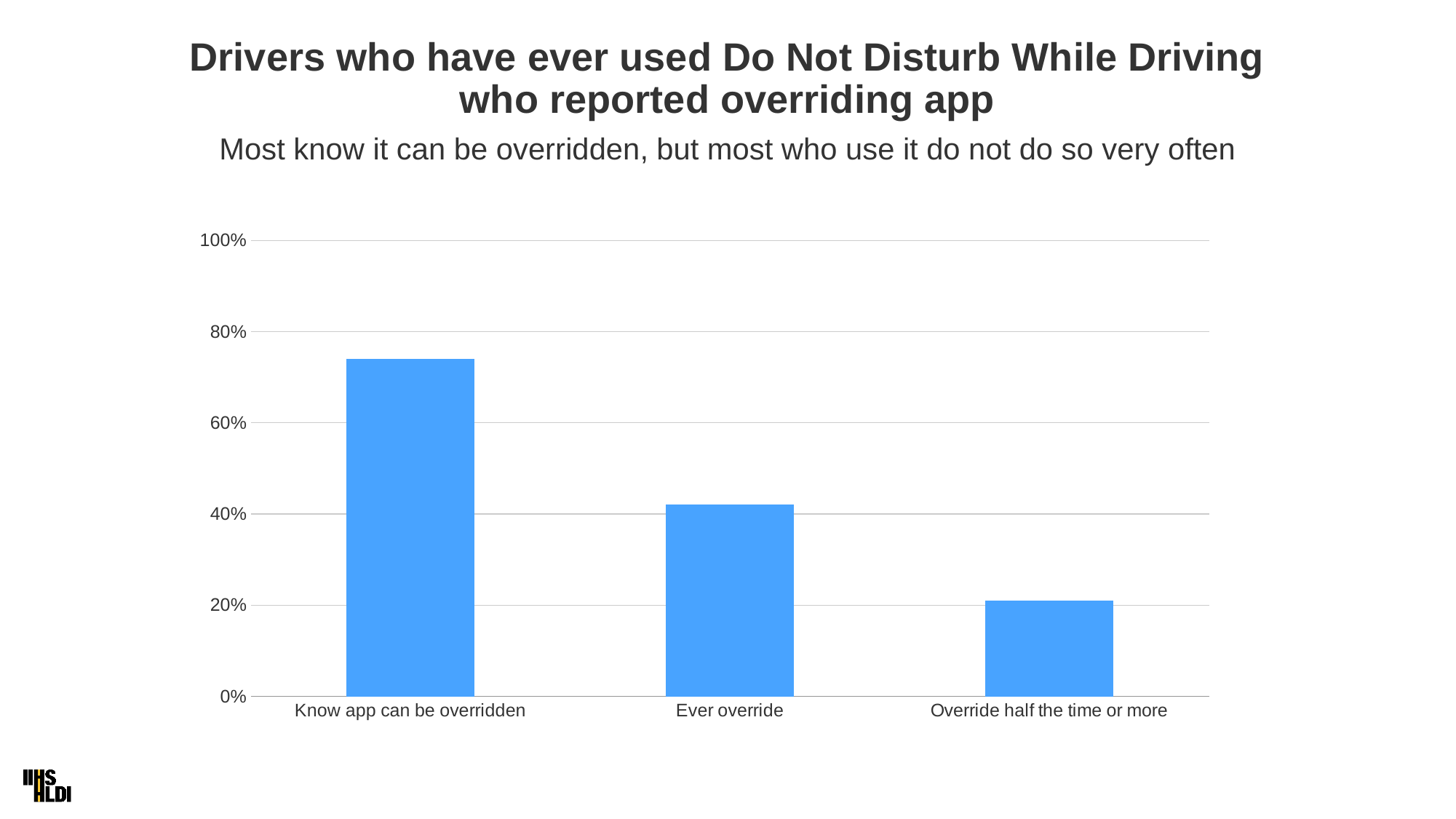
Is the value for Know app can be overridden greater or less than 80%? less Is the value for Override half the time or more greater or less than 40%? less How many categories are plotted in the chart? 3 What kind of chart is shown on the slide? bar chart Which category has the lowest value? Override half the time or more What is the title of the chart? Drivers who have ever used Do Not Disturb While Driving who reported overriding app What is the highest value shown on the vertical axis? 100% Is the value for Ever override greater or less than 60%? less Which category has the highest value? Know app can be overridden Which is larger, the value for Ever override or the value for Override half the time or more? Ever override Do the values rise or fall moving from left to right across the categories? fall